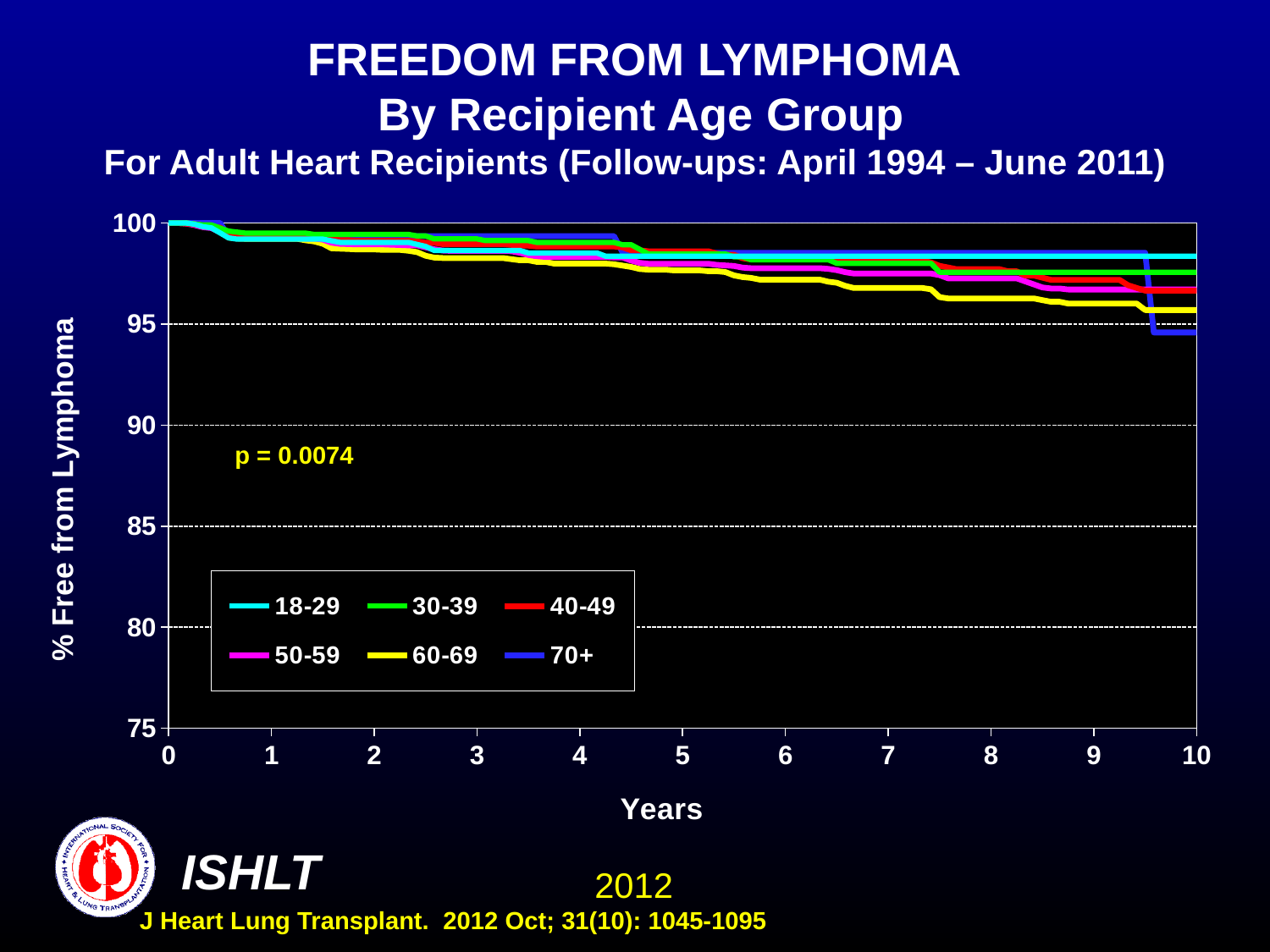
Do the % free from lymphoma curves rise or fall as years increase? fall How many recipient age groups does the legend list? 6 Is the value for the 70+ group at year 10 greater or less than 95? less Is the value for the 18-29 group at year 10 greater or less than 95? greater What is the label of the y axis? % Free from Lymphoma What p-value is shown on the chart? p = 0.0074 Which age group has the lowest % free from lymphoma at year 10? 70+ What kind of chart is shown on the slide? line chart Which age group has the highest % free from lymphoma at year 10? 18-29 Is the value for the 60-69 group at year 5 greater or less than 95? greater At year 10, which group has the higher % free from lymphoma, 18-29 or 60-69? 18-29 At year 10, which group has the higher % free from lymphoma, 60-69 or 70+? 60-69